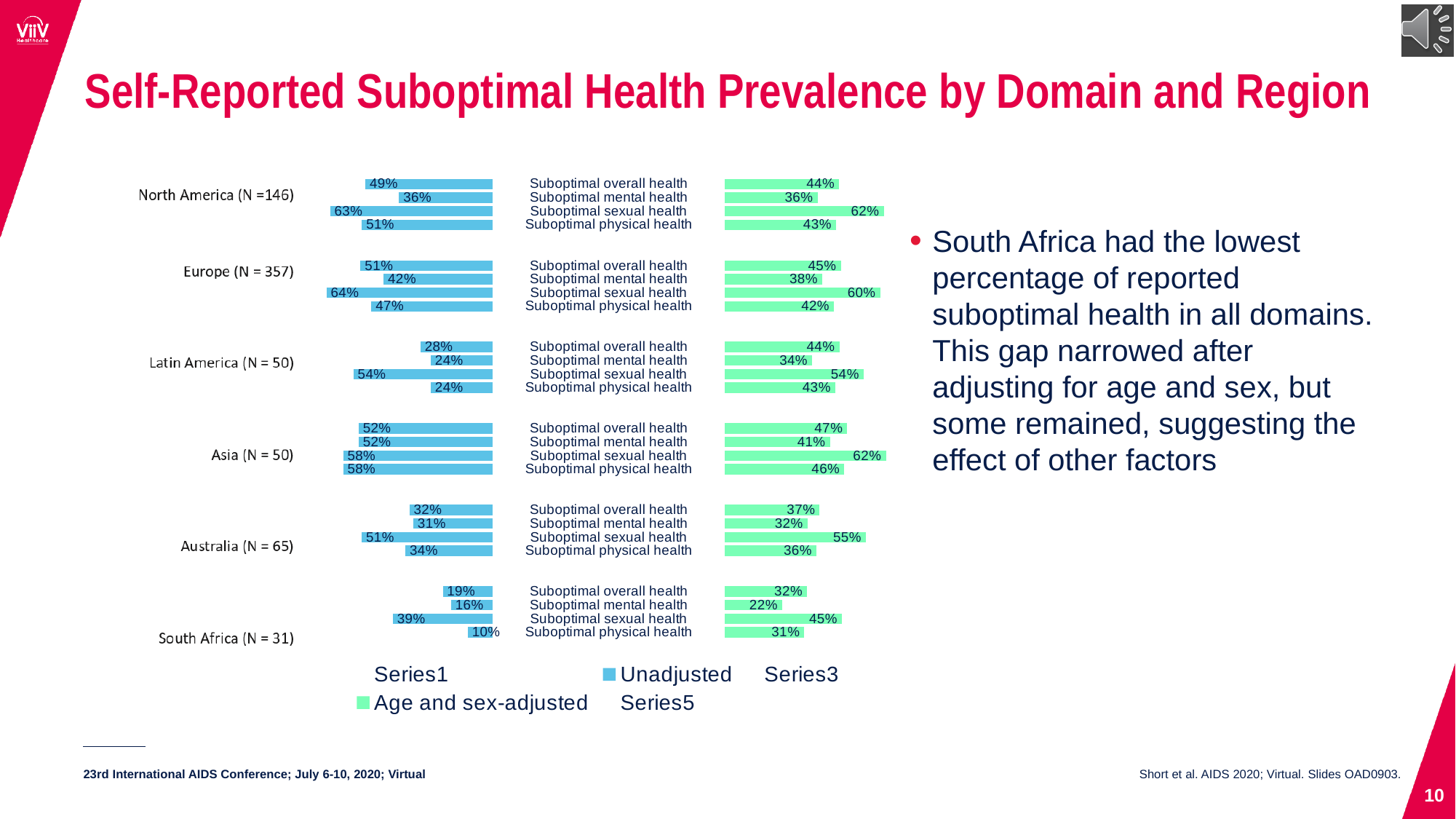
What is the unadjusted percentage for suboptimal physical health in South Africa (N = 31)? 10% Which legend entry do the green bars represent? Age and sex-adjusted What is the difference between the unadjusted and age and sex-adjusted percentages for suboptimal overall health in Asia (N = 50)? 5 percentage points What is the difference between the unadjusted and age and sex-adjusted percentages for suboptimal physical health in South Africa (N = 31)? 21 percentage points For Latin America (N = 50), which is larger for suboptimal overall health: the unadjusted or the age and sex-adjusted percentage? Age and sex-adjusted What is the age and sex-adjusted percentage for suboptimal mental health in South Africa (N = 31)? 22% Which region has the lowest unadjusted percentage for suboptimal physical health? South Africa (N = 31) What type of chart is shown on the slide? Bar chart Which region has the highest age and sex-adjusted percentage for suboptimal sexual health? North America (N =146) and Asia (N = 50), both 62% How many regions are shown in the chart? 6 What is the age and sex-adjusted percentage for suboptimal overall health in Asia (N = 50)? 47% What is the unadjusted percentage for suboptimal sexual health in Europe (N = 357)? 64%